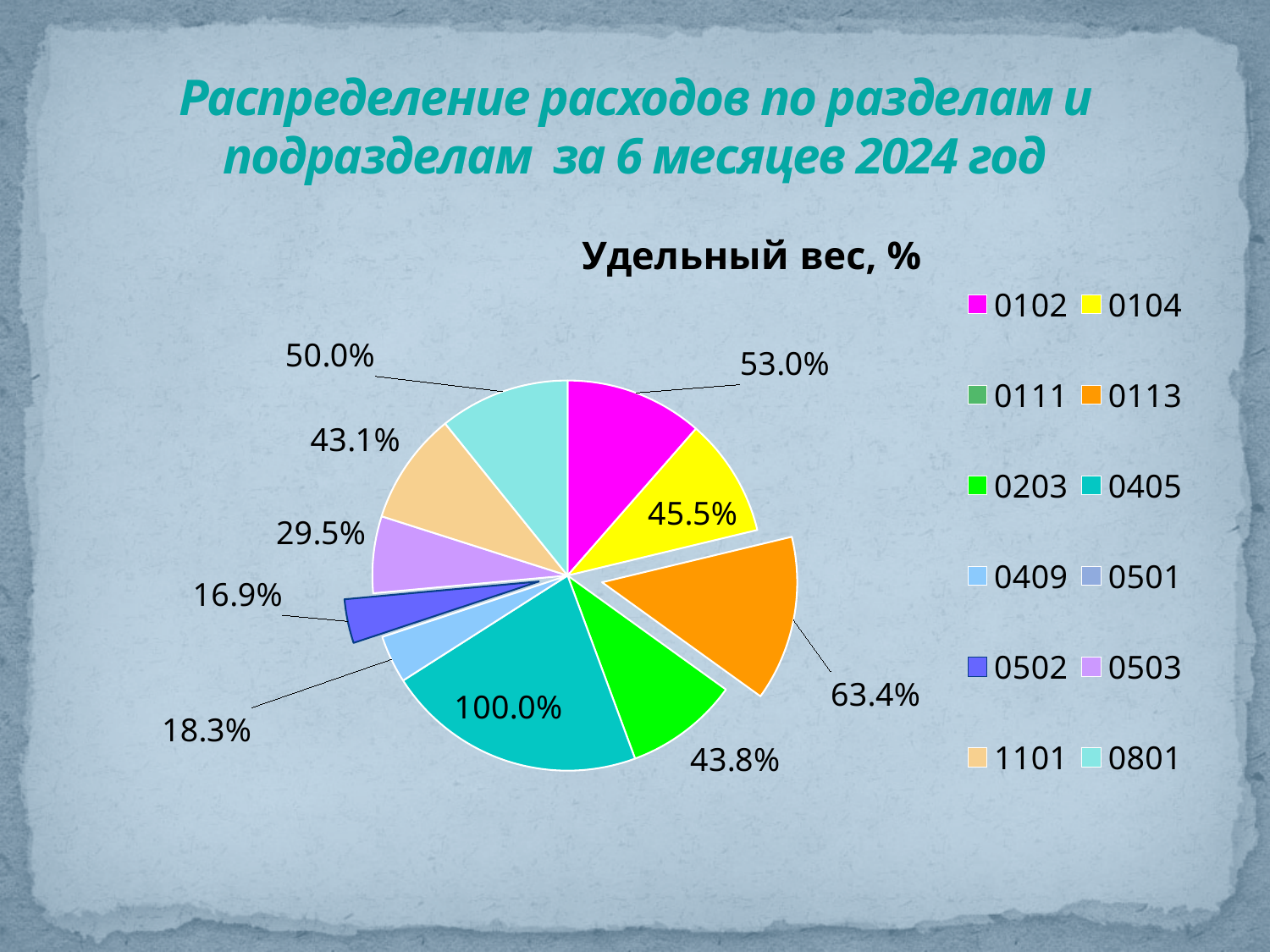
Which has the larger labelled value, 0104 or 0203? 0104 What value is labelled for category 0113? 63.4% What value is labelled for category 0102? 53.0% What value is labelled for category 0801? 50.0% How many entries does the chart legend list? 12 What value is labelled for category 0405? 100.0% Which category has the largest labelled value? 0405 What is the difference between the labelled values for 0113 and 0102? 10.4% What type of chart is shown on the slide? pie chart What value is labelled for category 0502? 16.9% What is the title of the chart? Удельный вес, % Which category has the smallest labelled value? 0502